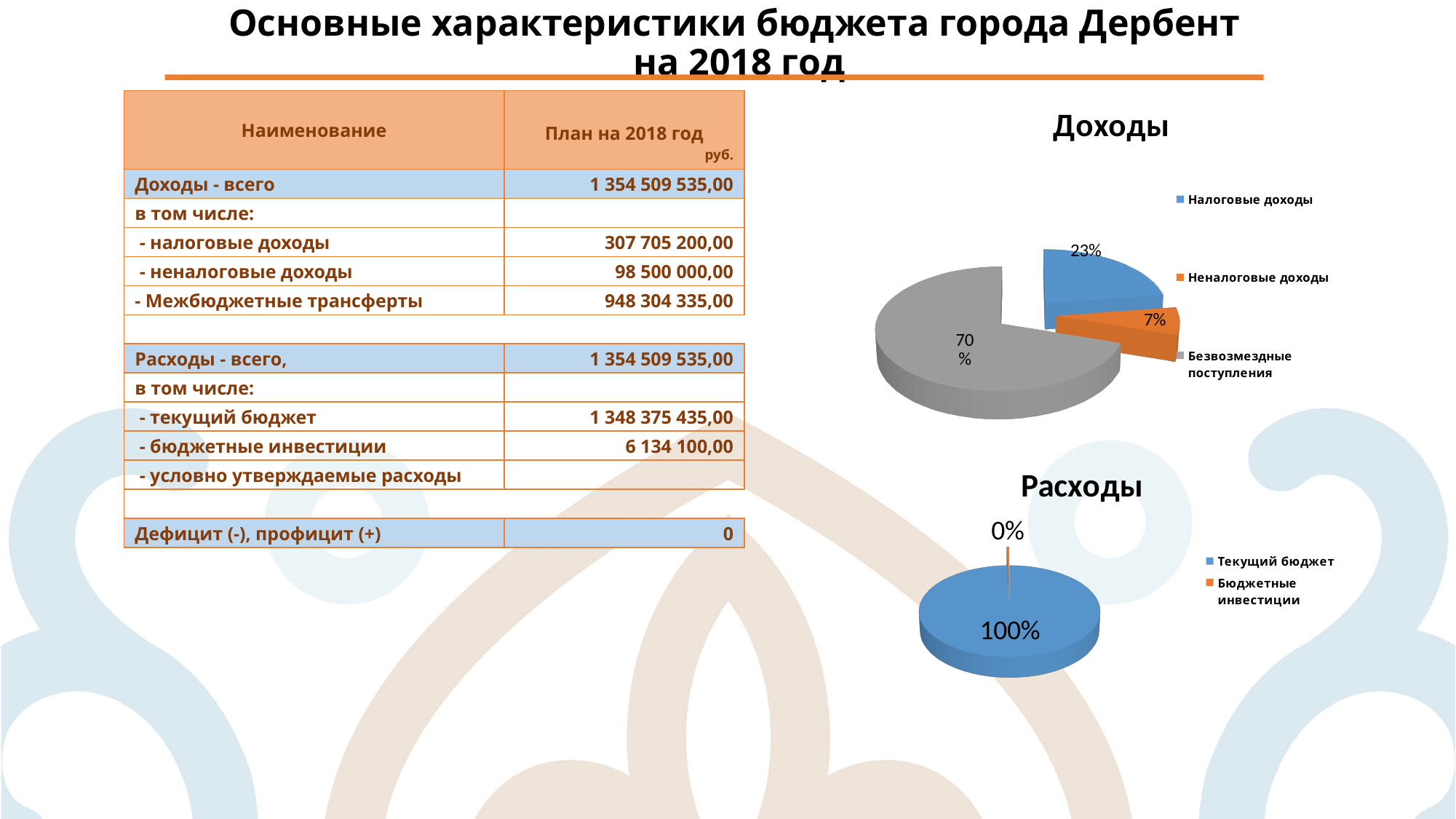
In the "Доходы" chart, what share is labelled for Налоговые доходы? 23% In the "Доходы" chart, which category has the largest slice? Безвозмездные поступления How many categories does the legend of the "Доходы" chart list? 3 In the "Расходы" chart, what share is labelled for Текущий бюджет? 100% What kind of chart is the "Доходы" chart? pie chart In the "Доходы" chart, how many percentage points larger is Безвозмездные поступления than Налоговые доходы? 47 In the "Доходы" chart, what share is labelled for Безвозмездные поступления? 70% In the "Доходы" chart, which category has the smallest slice? Неналоговые доходы How many categories does the legend of the "Расходы" chart list? 2 In the "Доходы" chart, which is larger: Налоговые доходы or Неналоговые доходы? Налоговые доходы